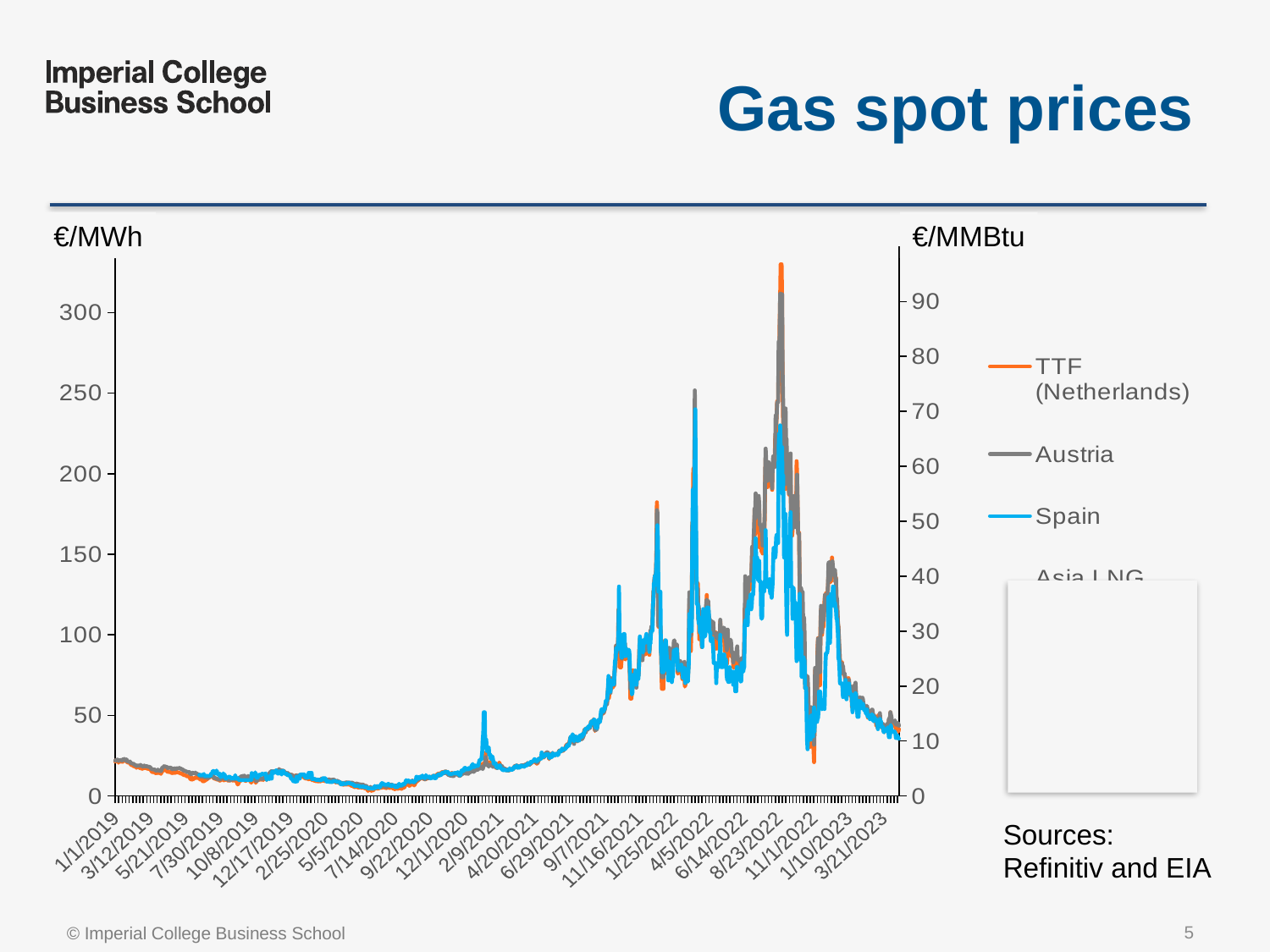
Is the value of the TTF (Netherlands) series at 1/1/2019 greater or less than 50 €/MWh? less Is the highest peak of the gas spot price series in 2022 greater or less than 300 €/MWh on the left axis? greater What kind of chart is shown on the slide? line chart Is the value of the Spain series around 7/14/2020 greater or less than 50 €/MWh? less Do the gas spot prices generally rise or fall between the peak around 8/23/2022 and 3/21/2023? fall What is the title of the chart on the slide? Gas spot prices Do the gas spot prices generally rise or fall between 1/1/2019 and 7/14/2020? fall What unit is shown on the left vertical axis of the chart? €/MWh Which series in the legend is drawn in blue? Spain Do the gas spot prices generally rise or fall between 2/9/2021 and 8/23/2022? rise